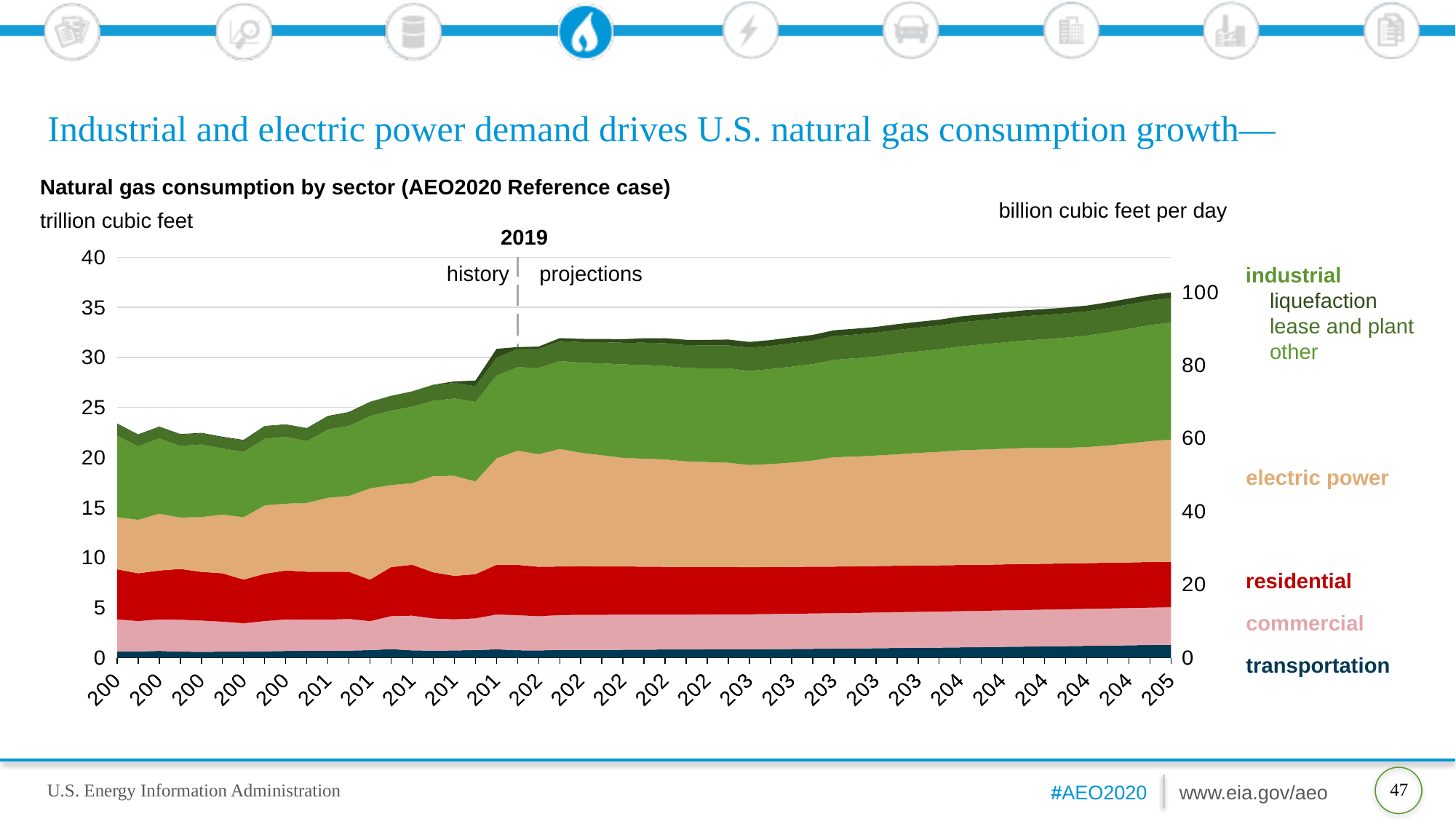
Which sector has the smallest natural gas consumption throughout the chart? transportation What is the highest value shown on the left vertical axis? 40 Is total natural gas consumption at the start of the chart (2000) greater or less than 25 trillion cubic feet? less What is the title of the chart? Natural gas consumption by sector (AEO2020 Reference case) What unit is shown on the left vertical axis of the chart? trillion cubic feet How many main sectors are labeled on the chart? 5 How many sub-categories are listed under the industrial sector? 3 Is total natural gas consumption at the end of the chart (2050) greater or less than 35 trillion cubic feet? greater What is the highest value shown on the right vertical axis? 100 Does total natural gas consumption rise or fall over the projection period? rise Which year separates history from projections in the chart? 2019 What kind of chart is shown on the slide? stacked area chart